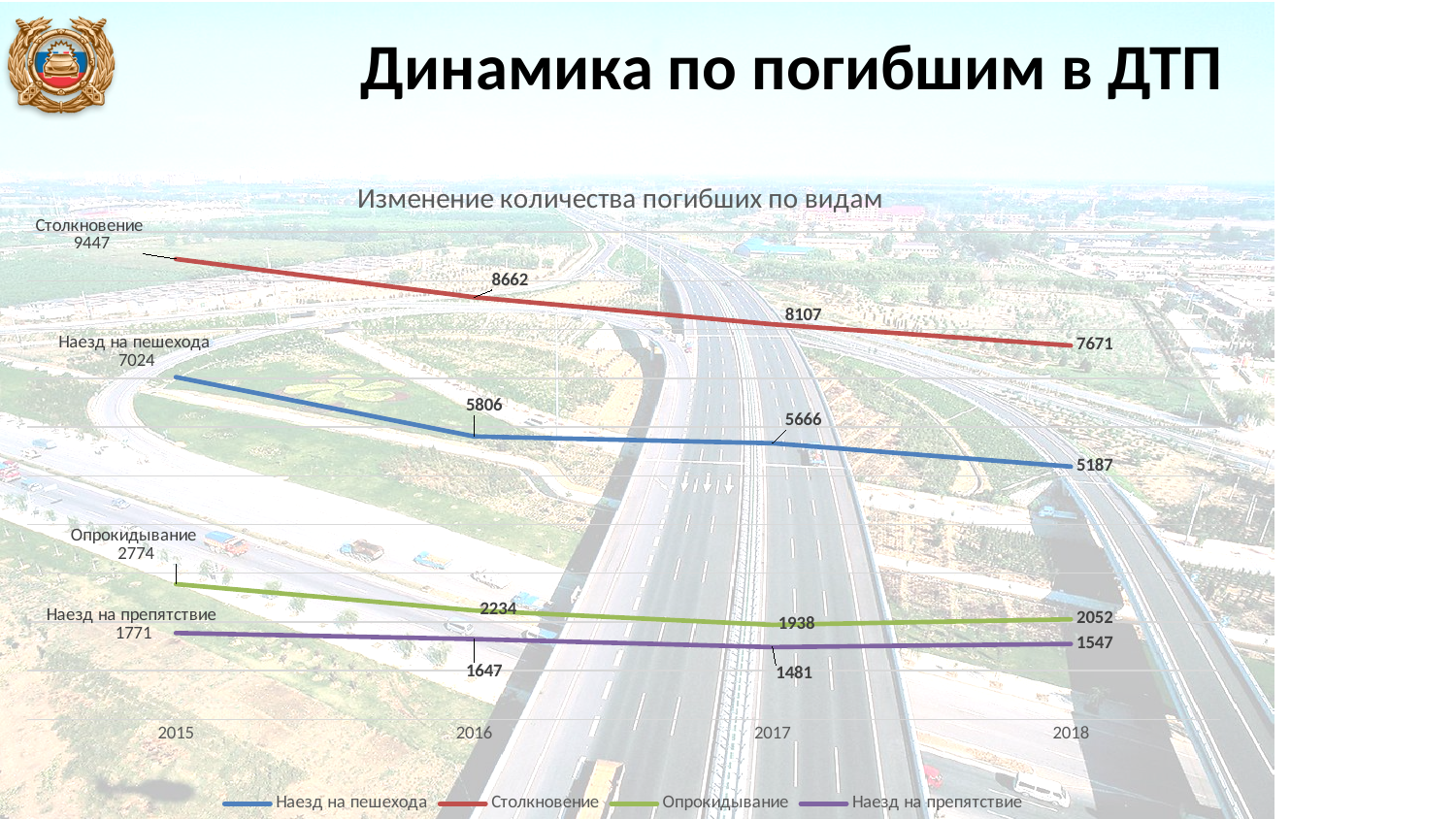
What type of chart is shown on the slide? line chart What is the value for Наезд на пешехода in 2018? 5187 Which series has the lowest value in 2015? Наезд на препятствие How many years are shown on the x axis? 4 Which is larger: Опрокидывание in 2018 or Наезд на препятствие in 2018? Опрокидывание in 2018 Which series has the highest value in 2018? Столкновение What is the value for Опрокидывание in 2017? 1938 What is the value for Наезд на препятствие in 2016? 1647 What is the difference between the Столкновение values in 2015 and 2018? 1776 How many series does the legend list? 4 What is the value for Столкновение in 2015? 9447 Does the Столкновение series rise or fall from 2015 to 2018? fall